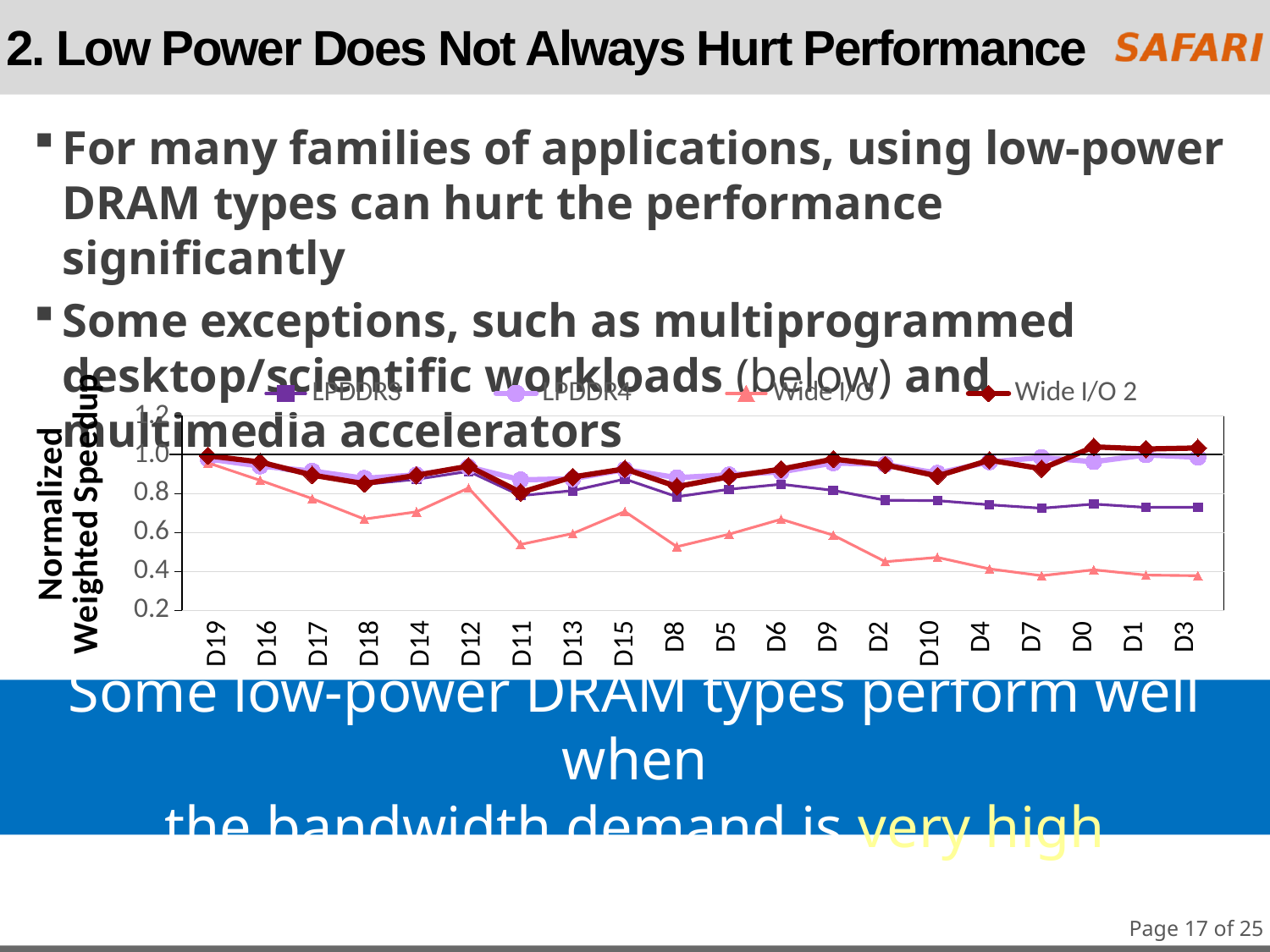
What is the title of the chart's y axis? Normalized Weighted Speedup How many categories are plotted along the x axis of the chart? 20 Is the Wide I/O value for D8 greater or less than 0.6? less Which series are listed in the chart's legend? LPDDR3, LPDDR4, Wide I/O, Wide I/O 2 Is the Wide I/O value for D2 greater or less than 0.6? less Does the Wide I/O series generally rise or fall from left to right along the x axis? fall Is the LPDDR3 value for D3 greater or less than 0.8? less What kind of chart is shown on the slide? line chart How many series does the chart's legend list? 4 At D3, which is larger: the Wide I/O 2 value or the Wide I/O value? Wide I/O 2